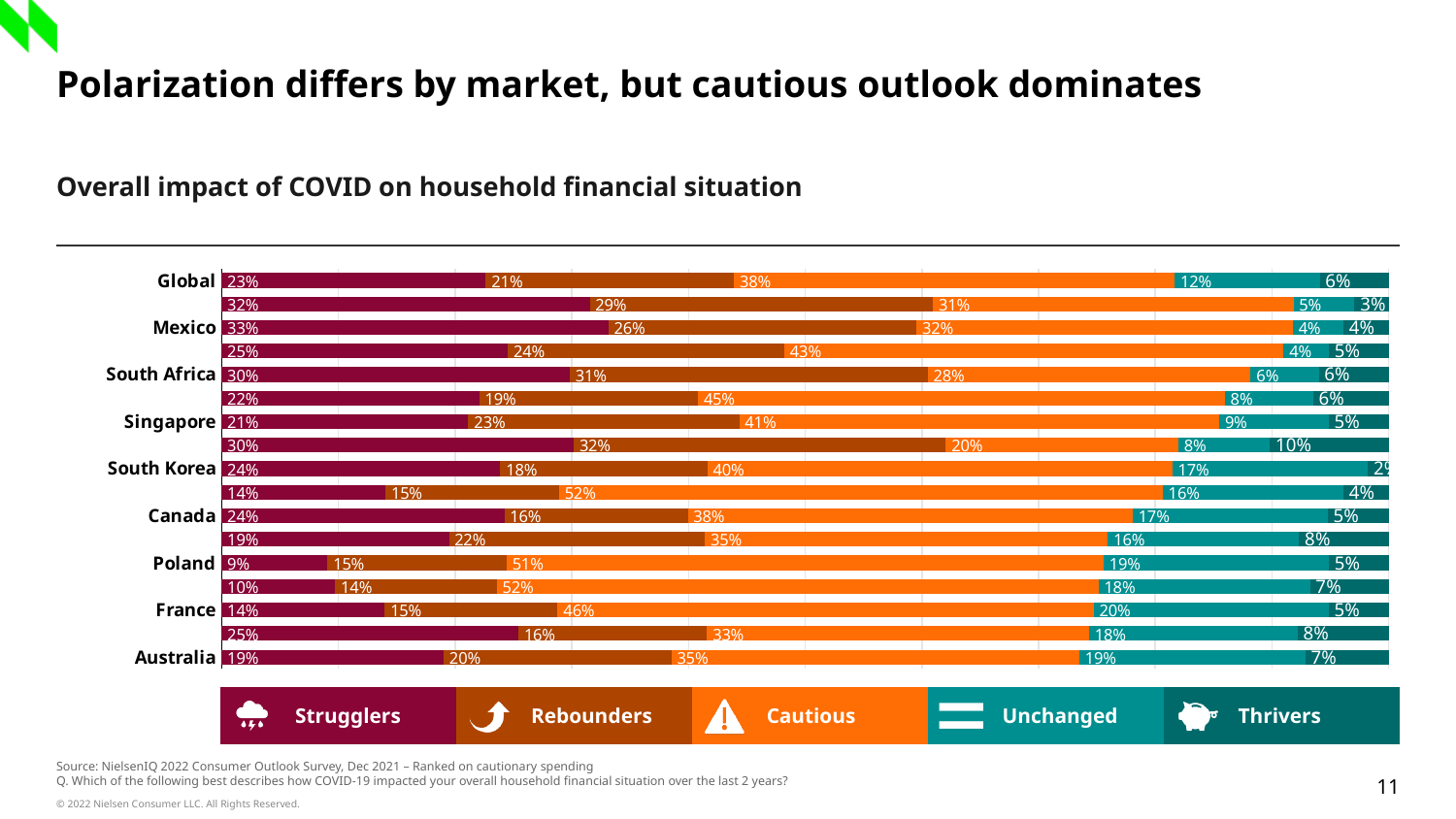
What is the Cautious value for Poland? 51% What is the Rebounders value for South Africa? 31% What are the five legend entries of the chart? Strugglers, Rebounders, Cautious, Unchanged, Thrivers Which has a larger Strugglers share, Mexico or Australia? Mexico How many series does the legend list? 5 What is the Thrivers value for Australia? 7% What is the Cautious value for Global? 38% What type of chart is shown on the slide? Stacked horizontal bar chart What is the total of the stacked bar for Global? 100% What is the Unchanged value for France? 20% What is the difference between the Cautious value for Global and the Cautious value for Mexico? 6 percentage points What is the Strugglers value for Mexico? 33%